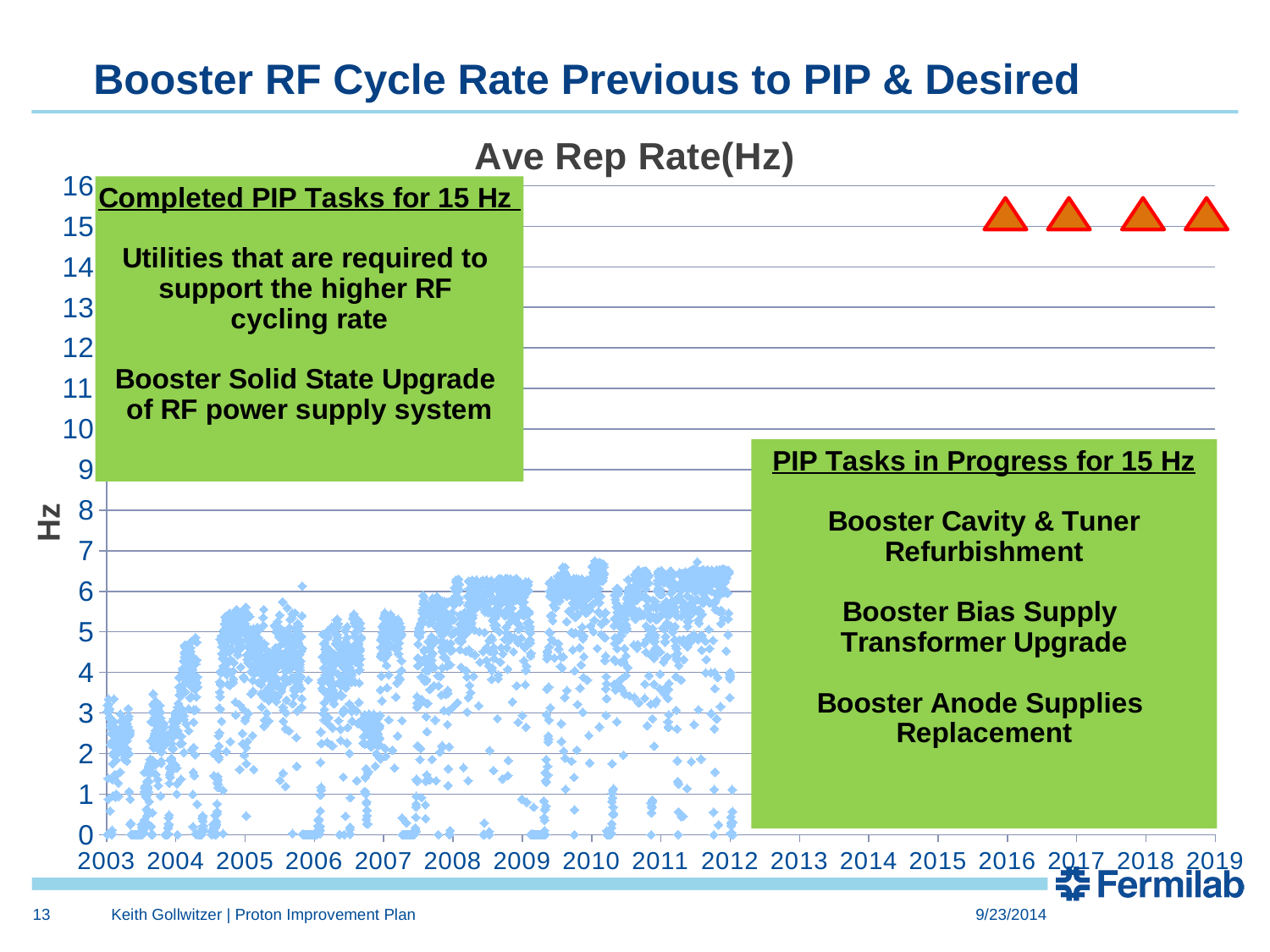
What is the title of the chart? Ave Rep Rate(Hz) Are the orange triangle markers plotted at a value greater or less than 10 Hz? greater Are the blue data points for 2003 greater or less than 5 Hz? less What kind of chart is shown on the slide? scatter chart Do the upper values of the blue data points generally rise or fall from 2003 to 2012? rise How many orange triangle markers are plotted on the chart? 4 What is the label on the vertical axis of the chart? Hz At what Hz value on the vertical axis do the orange triangle markers sit? 15 What is the last year shown on the horizontal axis? 2019 What is the first year shown on the horizontal axis? 2003 What is the highest tick value shown on the vertical axis? 16 Which is plotted higher on the chart: the orange triangle markers or the blue data points? the orange triangle markers